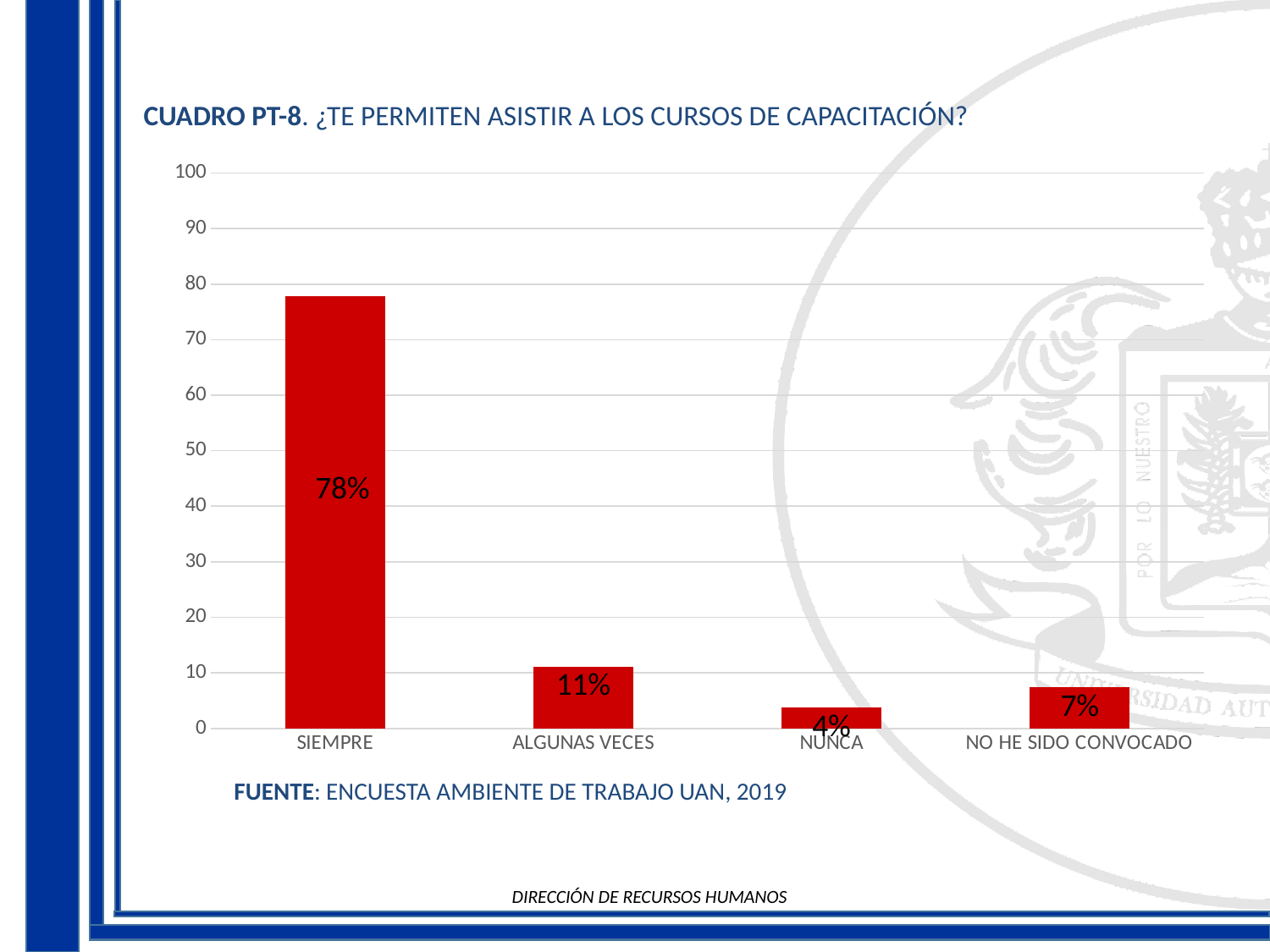
What is the value for ALGUNAS VECES? 11% Which category has the highest value? SIEMPRE What is the difference between the values for SIEMPRE and ALGUNAS VECES? 67% What is the value for SIEMPRE? 78% What is the value for NUNCA? 4% How many categories are shown on the x axis? 4 Which category has the lowest value? NUNCA What is the value for NO HE SIDO CONVOCADO? 7% What kind of chart is shown on the slide? bar chart Which is larger, the value for NO HE SIDO CONVOCADO or the value for NUNCA? NO HE SIDO CONVOCADO Is the value for SIEMPRE greater or less than 70? greater What source is cited below the chart? ENCUESTA AMBIENTE DE TRABAJO UAN, 2019